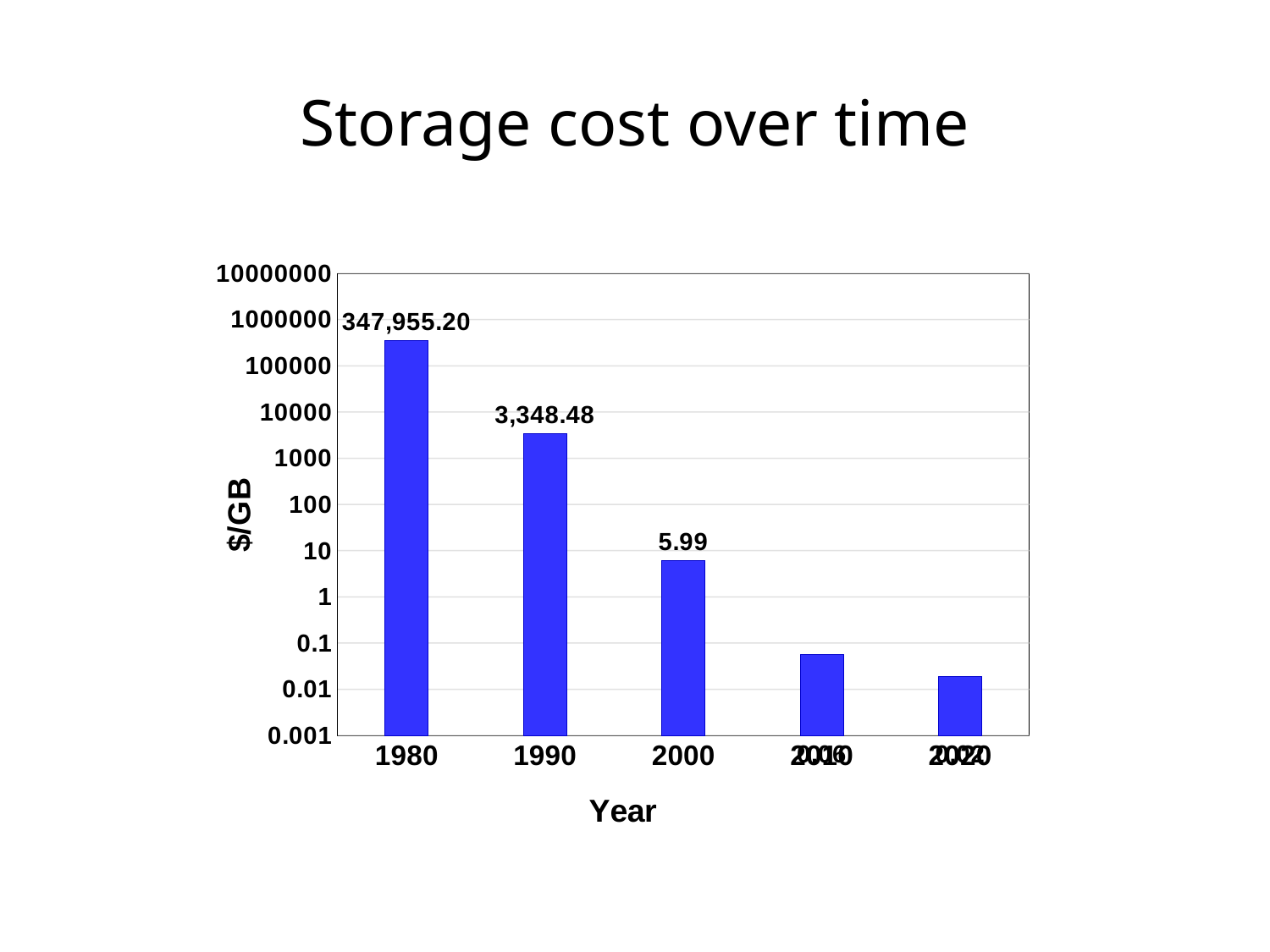
What is the storage cost in $/GB for 1990? 3,348.48 Do the storage cost values rise or fall as the years increase along the x axis? fall Is the value for 2000 greater or less than 10? less What is the difference between the storage cost in 1980 and in 1990? 344,606.72 Which year has the larger storage cost, 1990 or 2000? 1990 What is the difference between the storage cost in 1990 and in 2000? 3,342.49 What is the storage cost in $/GB for 2000? 5.99 Is the value for 1990 greater or less than 1000? greater Which year has the highest storage cost per GB? 1980 What kind of chart is shown on the slide? bar chart How many bars are plotted in the chart? 5 What is the storage cost in $/GB for 1980? 347,955.20